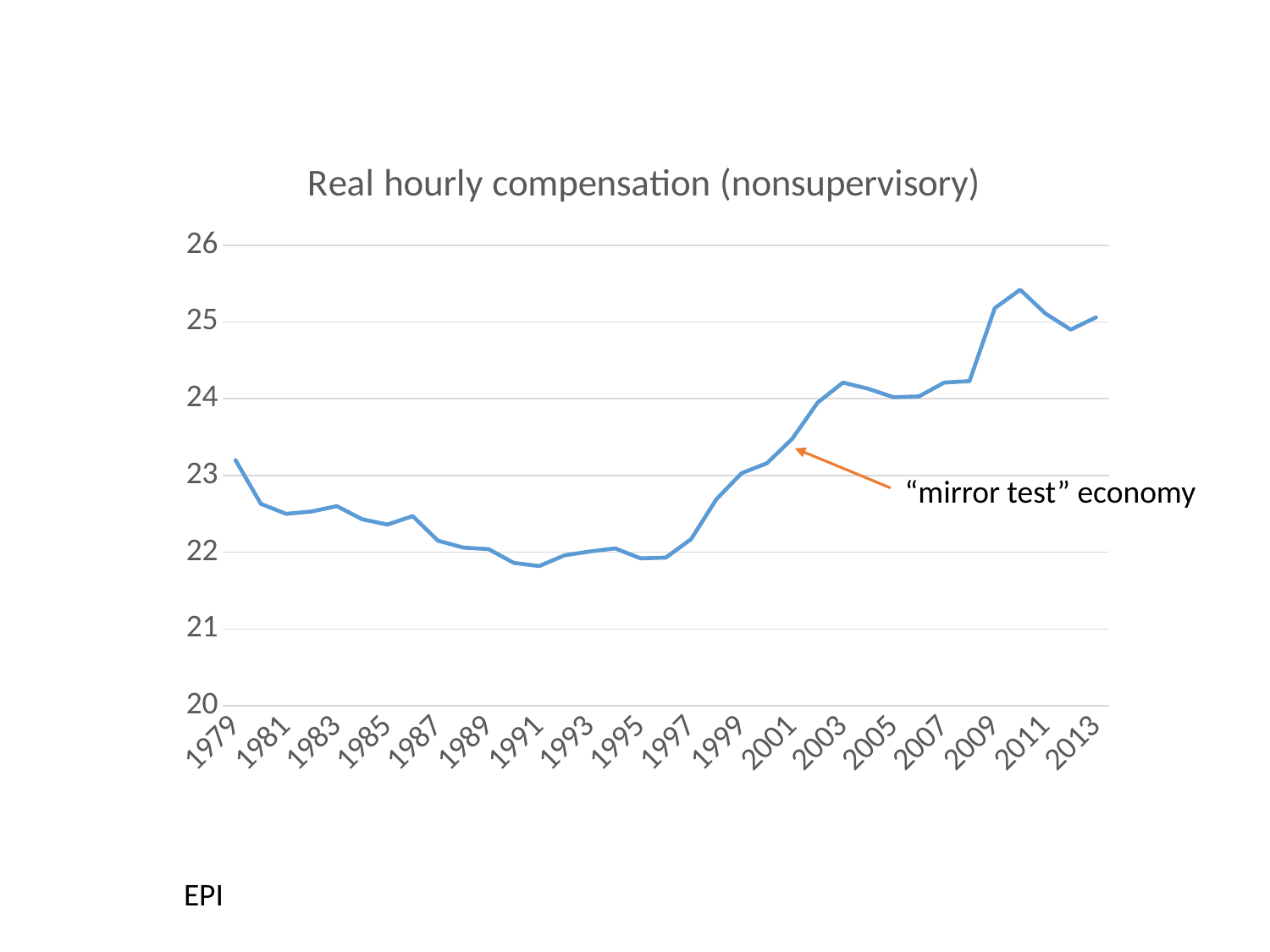
Which is larger, the value for 1983 or the value for 1991? 1983 How many year labels are shown on the x axis? 18 Which is larger, the value for 1979 or the value for 2013? 2013 Is the value for 1991 greater or less than 22? less Is the value for 2003 greater or less than 24? greater Is the value for 1985 greater or less than 23? less What is the title of the chart? Real hourly compensation (nonsupervisory) Does the line generally rise or fall between 1997 and 2009? Rise What text does the orange arrow annotation on the chart say? "mirror test" economy What kind of chart is shown on the slide? Line chart